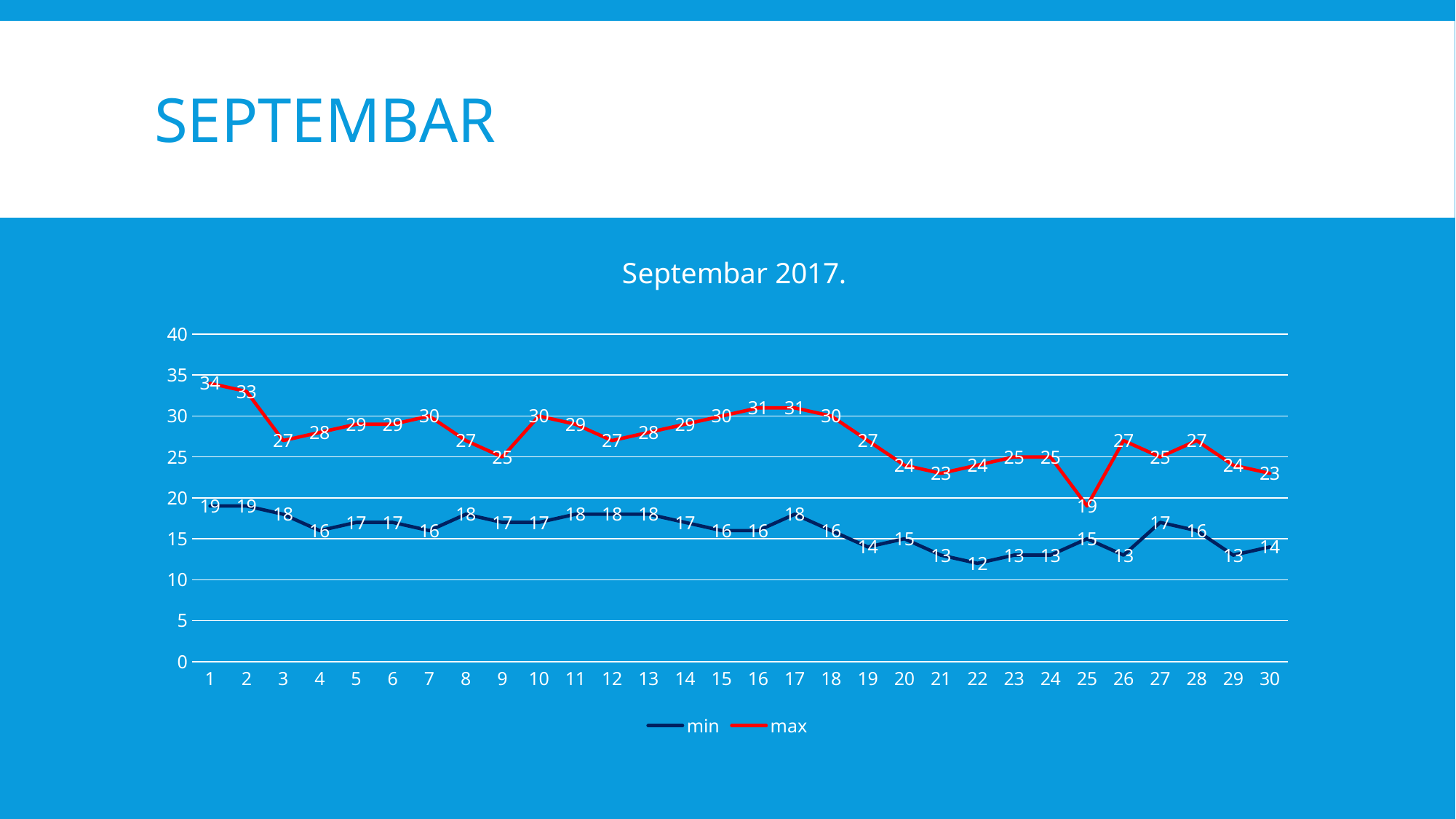
On which day is the max series at its lowest? 25 What kind of chart is shown? line chart How many days are plotted on the x axis? 30 On which day is the max series at its highest? 1 What is the max value on day 1? 34 What is the difference between the max and min values on day 1? 15 On which day is the min series at its lowest? 22 What is the min value on day 22? 12 How many series does the legend list? 2 Which is larger, the max value on day 10 or the max value on day 12? day 10 What is the max value on day 25? 19 What is the difference between the max value on day 17 and the max value on day 21? 8